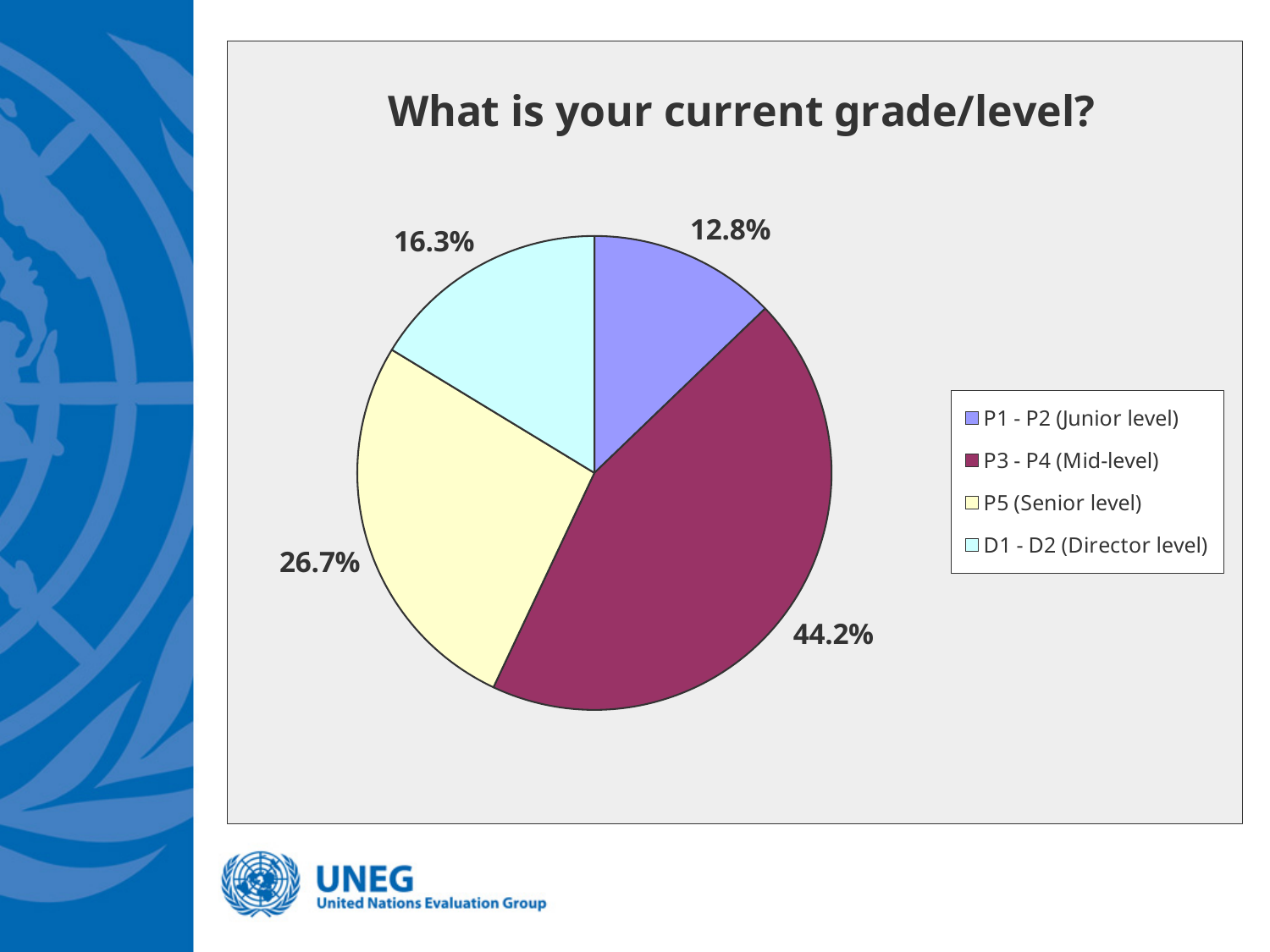
What type of chart is shown on the slide? Pie chart How many grade/level categories are shown in the pie chart? 4 What is the difference in percentage points between the P3 - P4 (Mid-level) and P5 (Senior level) shares? 17.5 Which grade/level has the smallest share of respondents? P1 - P2 (Junior level) What is the title of the chart? What is your current grade/level? Which has a larger share, P5 (Senior level) or D1 - D2 (Director level)? P5 (Senior level) What percentage of respondents are at the P5 (Senior level) grade? 26.7% Which colour represents the P3 - P4 (Mid-level) slice? Dark red/maroon What percentage of respondents are at the P1 - P2 (Junior level) grade? 12.8% Which grade/level has the largest share of respondents? P3 - P4 (Mid-level) What percentage of respondents are at the D1 - D2 (Director level) grade? 16.3% What percentage of respondents are at the P3 - P4 (Mid-level) grade? 44.2%